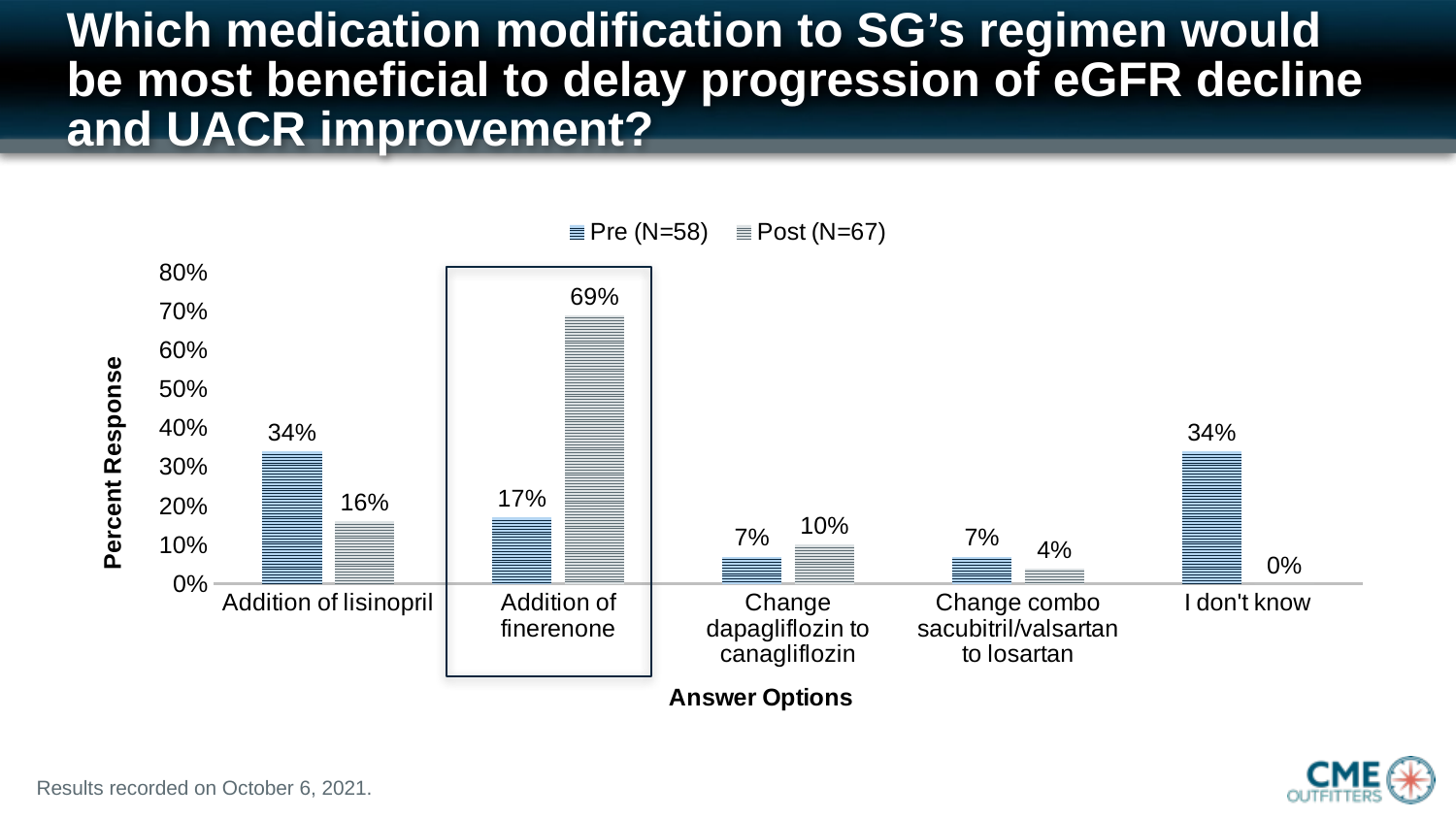
What is the Post (N=67) value for Change combo sacubitril/valsartan to losartan? 4% What is the difference between the Post (N=67) and Pre (N=58) values for Addition of finerenone? 52% Which is larger for Change dapagliflozin to canagliflozin: the Pre (N=58) value or the Post (N=67) value? Post (N=67) Which answer option has the highest Post (N=67) value? Addition of finerenone How many answer options are shown on the x axis? 5 What is the difference between the Pre (N=58) and Post (N=67) values for Addition of lisinopril? 18% What is the Pre (N=58) value for I don't know? 34% How many series does the legend list? 2 Which answer option has the lowest Post (N=67) value? I don't know What kind of chart is shown on the slide? Bar chart What is the Pre (N=58) value for Addition of lisinopril? 34% What is the Post (N=67) value for Addition of finerenone? 69%